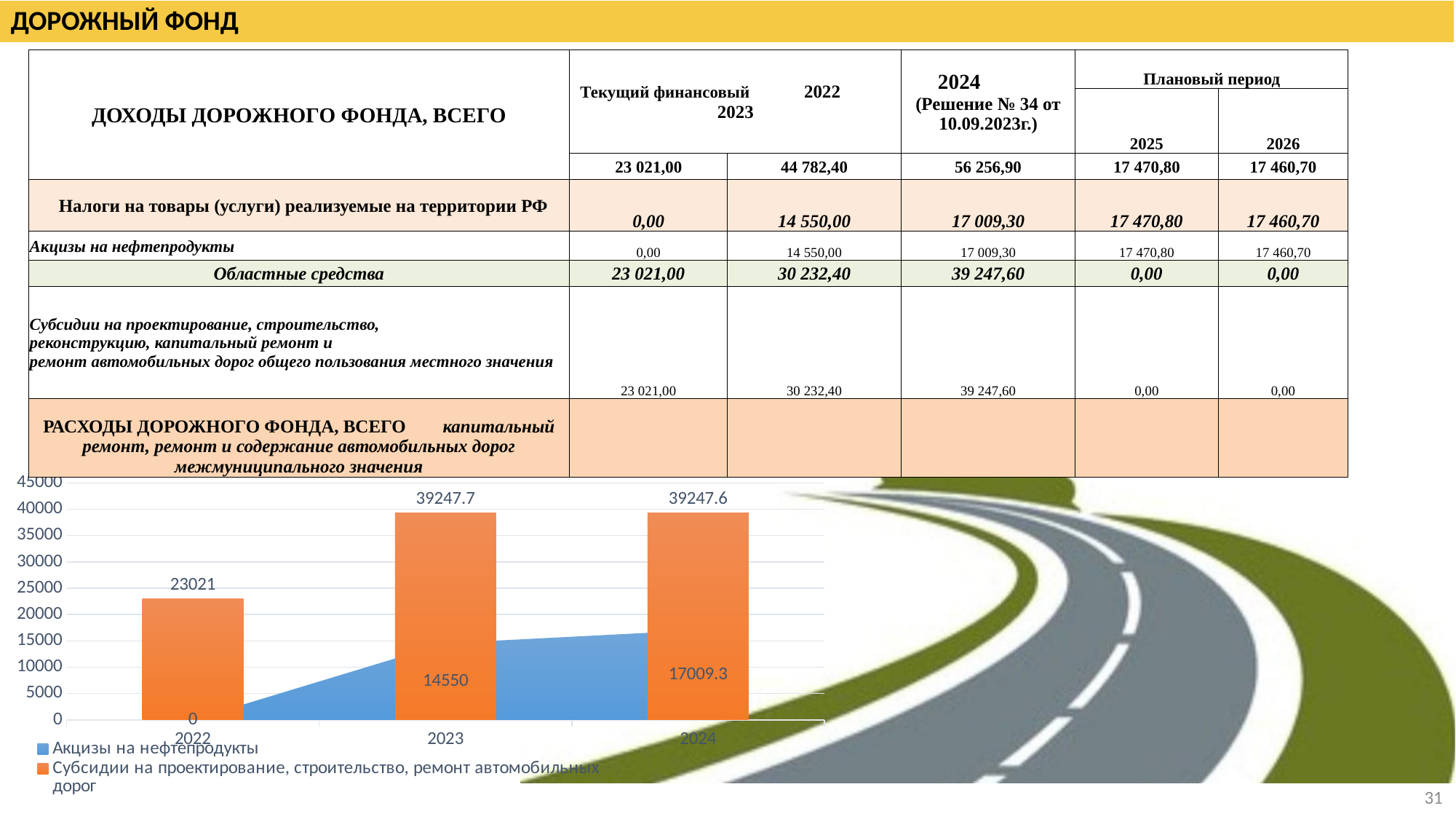
What is the value of Акцизы на нефтепродукты for 2024? 17009.3 What is the value of Акцизы на нефтепродукты for 2022? 0 How many years are shown on the x axis of the chart? 3 In which year is Акцизы на нефтепродукты highest? 2024 What is the value of Акцизы на нефтепродукты for 2023? 14550 Does Акцизы на нефтепродукты rise or fall from 2022 to 2024? rise What is the value of Субсидии на проектирование, строительство, ремонт автомобильных дорог for 2023? 39247.7 How many series does the chart legend list? 2 What is the difference between the Субсидии values for 2023 and 2022? 16226.7 What is the value of Субсидии на проектирование, строительство, ремонт автомобильных дорог for 2022? 23021 In which year is Субсидии на проектирование, строительство, ремонт автомобильных дорог lowest? 2022 Which is larger in 2023: Субсидии на проектирование, строительство, ремонт автомобильных дорог or Акцизы на нефтепродукты? Субсидии на проектирование, строительство, ремонт автомобильных дорог